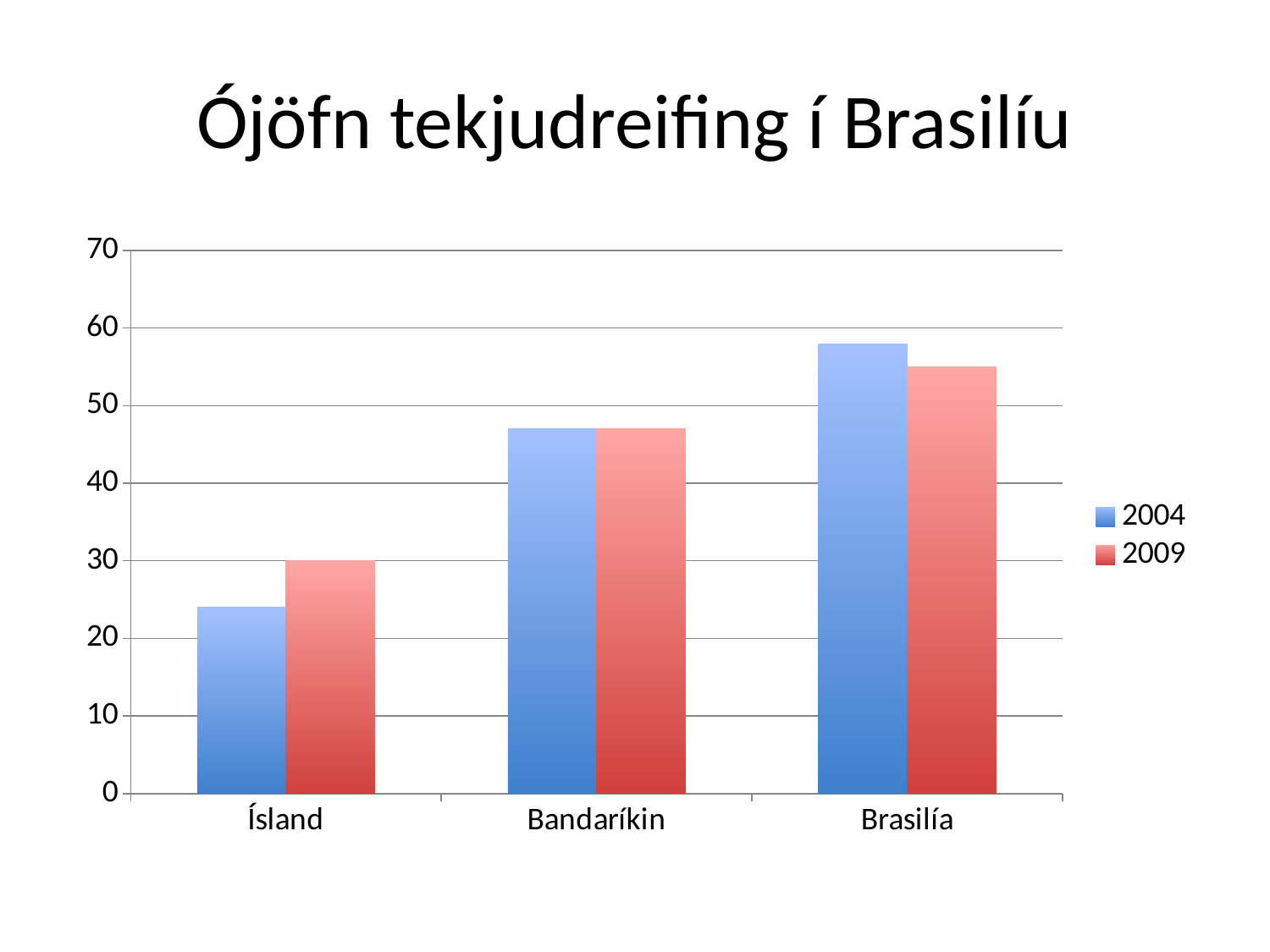
Is the value for Bandaríkin in 2009 greater or less than 40? greater Which category has the lowest value for 2004? Ísland What kind of chart is shown on the slide? bar chart How many categories are shown on the x axis? 3 Which colour represents the 2009 series in the legend? red Which category has the highest value for 2004? Brasilía How many series does the legend list? 2 For Ísland, which is larger, the 2004 value or the 2009 value? 2009 What is the title of the slide? Ójöfn tekjudreifing í Brasilíu Which category has the lowest value for 2009? Ísland Is the value for Brasilía in 2004 greater or less than 50? greater Is the value for Ísland in 2004 greater or less than 30? less